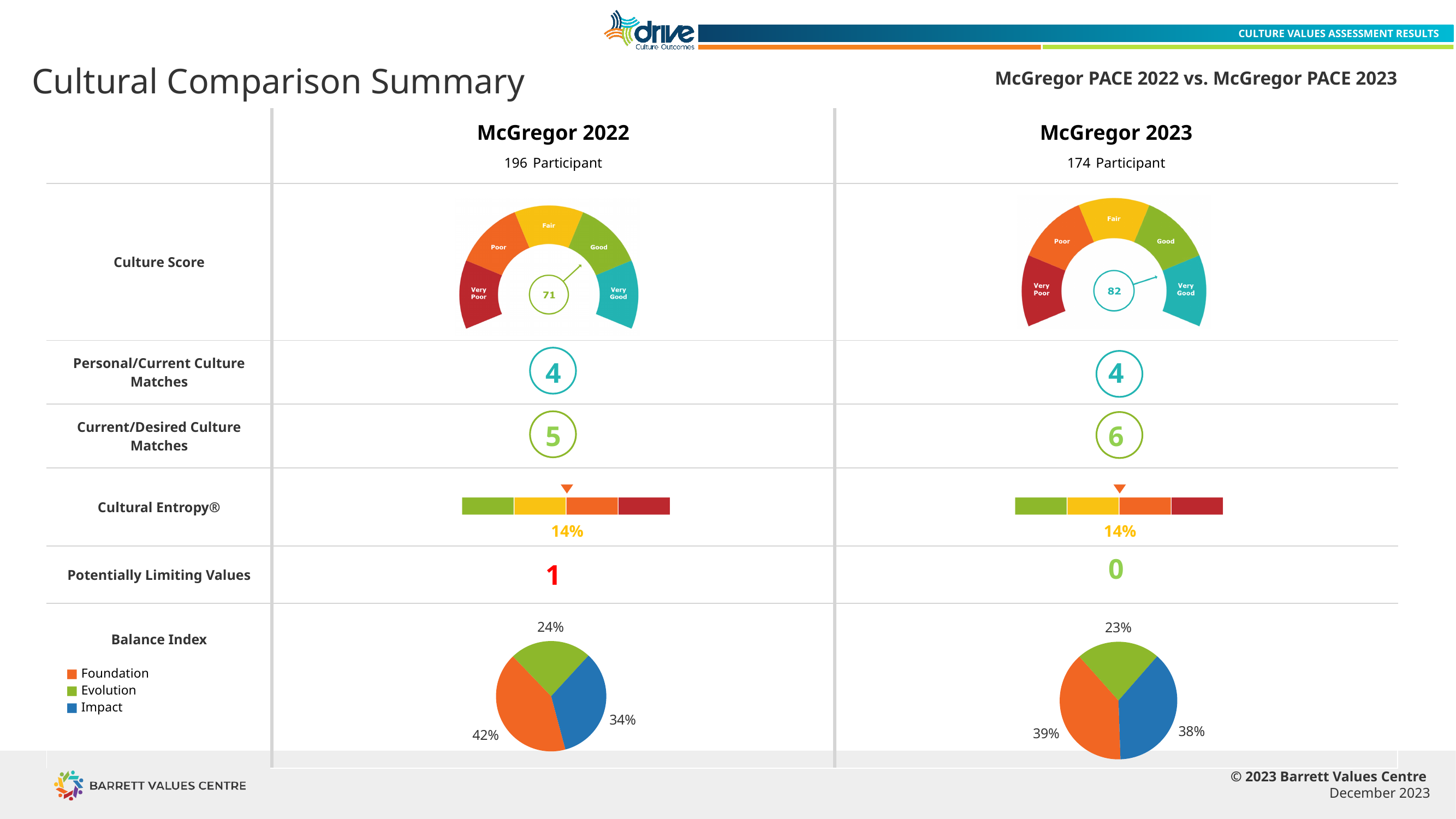
In the McGregor 2022 Balance Index pie chart, which is larger, Impact or Evolution? Impact What is the Cultural Entropy value shown for McGregor 2022? 14% What is the Culture Score shown on the McGregor 2023 gauge? 82 In the McGregor 2023 Balance Index pie chart, which category has the smallest share? Evolution How many categories does the Balance Index legend list? 3 In the McGregor 2023 Balance Index pie chart, what share is Impact? 38% What kind of chart is used for the Balance Index? Pie chart In the McGregor 2022 Balance Index pie chart, what is the difference between the Foundation and Evolution shares? 18% How many slices does the McGregor 2023 Balance Index pie chart have? 3 In the McGregor 2022 Balance Index pie chart, which category has the largest share? Foundation In the Balance Index legend, which colour represents Impact? Blue In the McGregor 2022 Balance Index pie chart, what share is Foundation? 42%